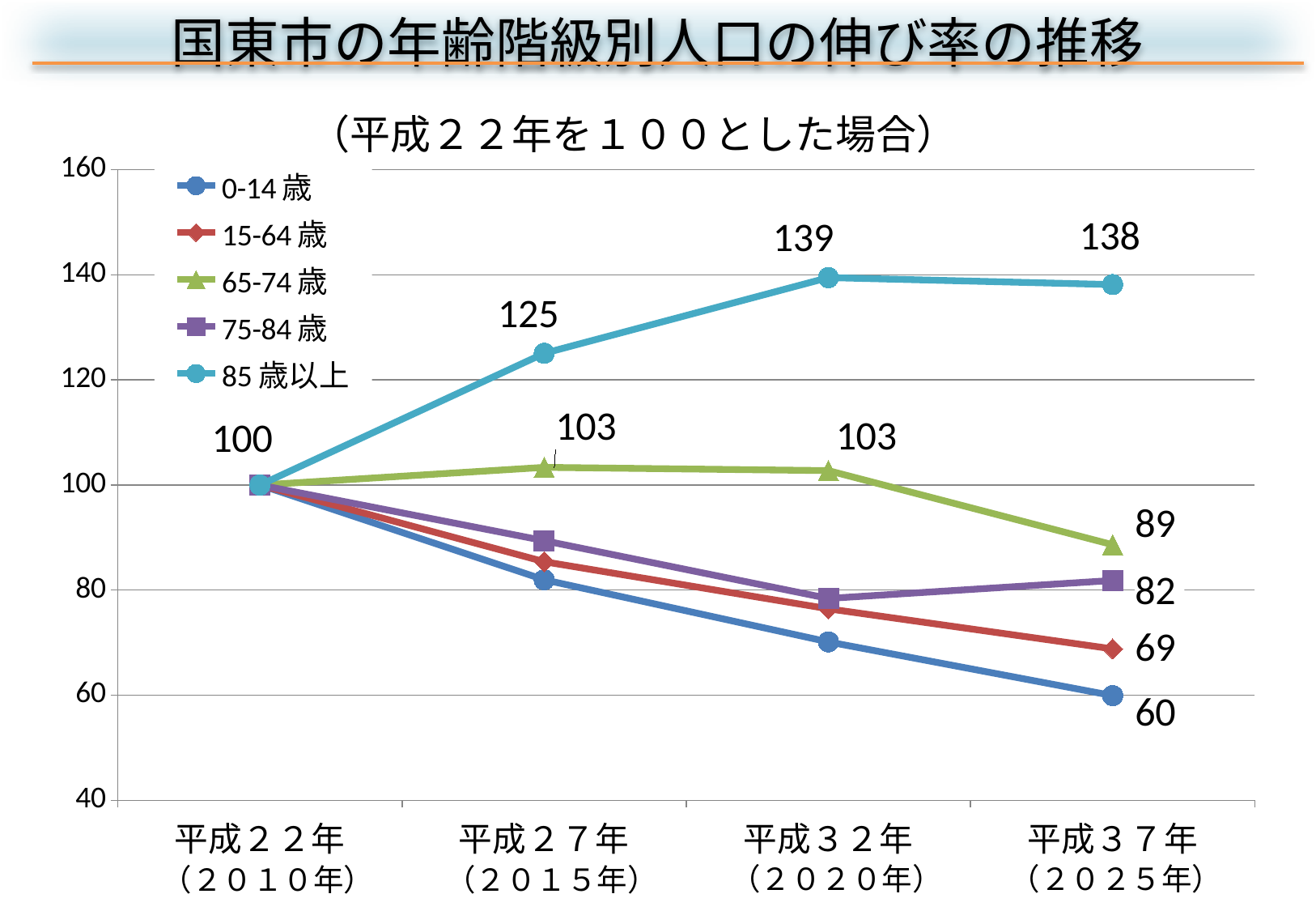
What kind of chart is shown on the slide? line chart What is the difference between the 85歳以上 value and the 0-14歳 value in 平成37年（2025年）? 78 How many points along the x axis does each line have? 4 What is the value for 65-74歳 in 平成37年（2025年）? 89 What is the value for 85歳以上 in 平成32年（2020年）? 139 Which series has the highest value in 平成37年（2025年）? 85歳以上 How many series does the legend list? 5 Is the value for 0-14歳 in 平成32年（2020年） greater or less than 80? less What is the value for 0-14歳 in 平成37年（2025年）? 60 Which series has the lowest value in 平成37年（2025年）? 0-14歳 Does the 0-14歳 line rise or fall from 平成22年 to 平成37年? fall What is the value for 85歳以上 in 平成27年（2015年）? 125